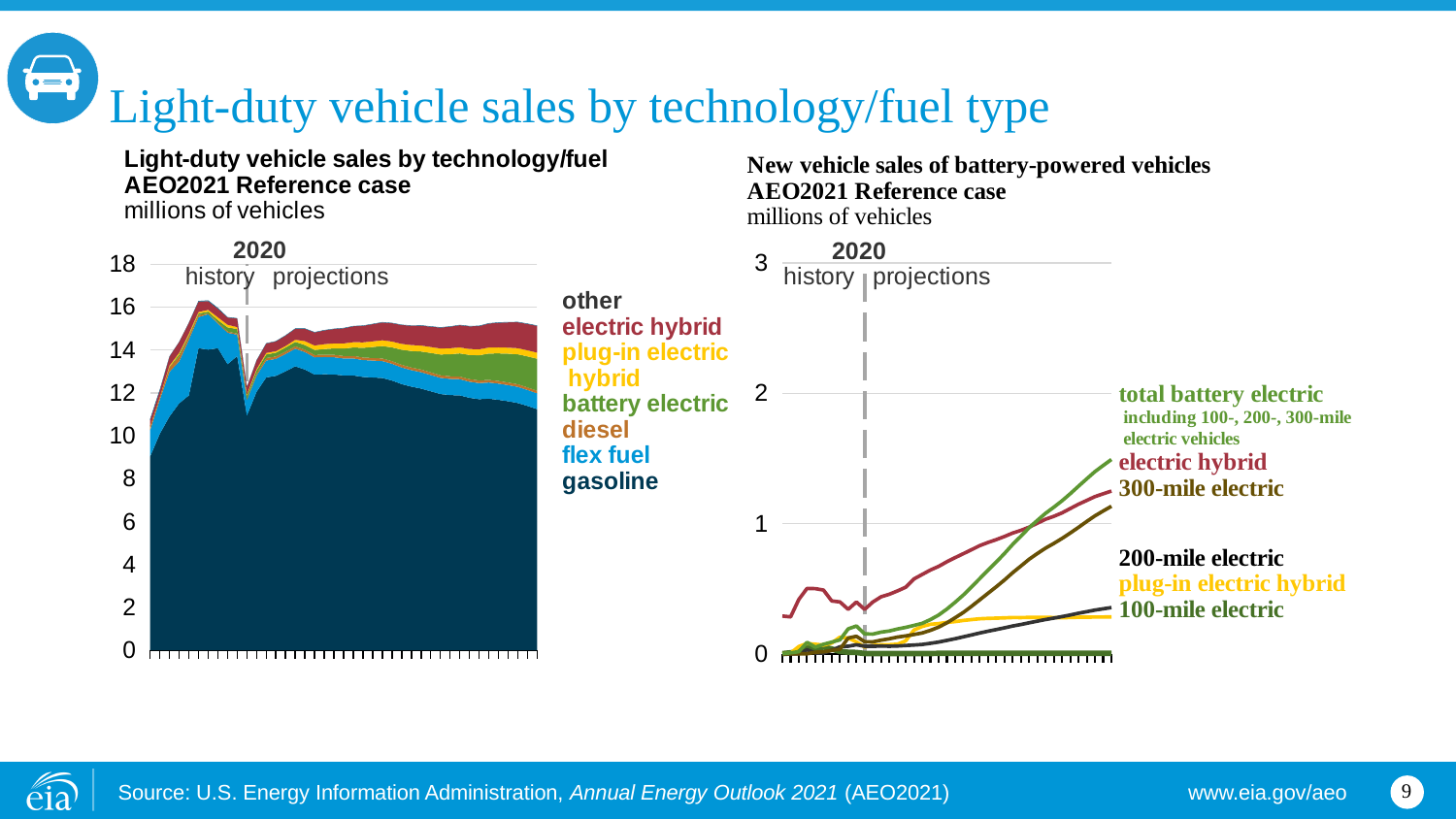
In the right chart, 'New vehicle sales of battery-powered vehicles', is the value for total battery electric at the end of the projections greater or less than 1? greater How many series are labelled on the right chart, 'New vehicle sales of battery-powered vehicles'? 6 What kind of chart is the left chart, 'Light-duty vehicle sales by technology/fuel'? stacked area chart In the right chart, 'New vehicle sales of battery-powered vehicles', which is larger at the end of the projections: total battery electric or plug-in electric hybrid? total battery electric In the right chart, 'New vehicle sales of battery-powered vehicles', is the value for 100-mile electric at the end of the projections greater or less than 1? less What kind of chart is the right chart, 'New vehicle sales of battery-powered vehicles'? line chart In the right chart, 'New vehicle sales of battery-powered vehicles', do sales of total battery electric vehicles rise or fall over the projection period? rise In the left chart, 'Light-duty vehicle sales by technology/fuel', which fuel type accounts for the largest share of sales throughout the period? gasoline What unit is used on the y axis of both charts? millions of vehicles In the left chart, 'Light-duty vehicle sales by technology/fuel', is the total of all vehicle sales at the end of the projections greater or less than 14? greater How many series does the legend of the left chart, 'Light-duty vehicle sales by technology/fuel', list? 7 In the right chart, 'New vehicle sales of battery-powered vehicles', which series is highest at the end of the projection period? total battery electric